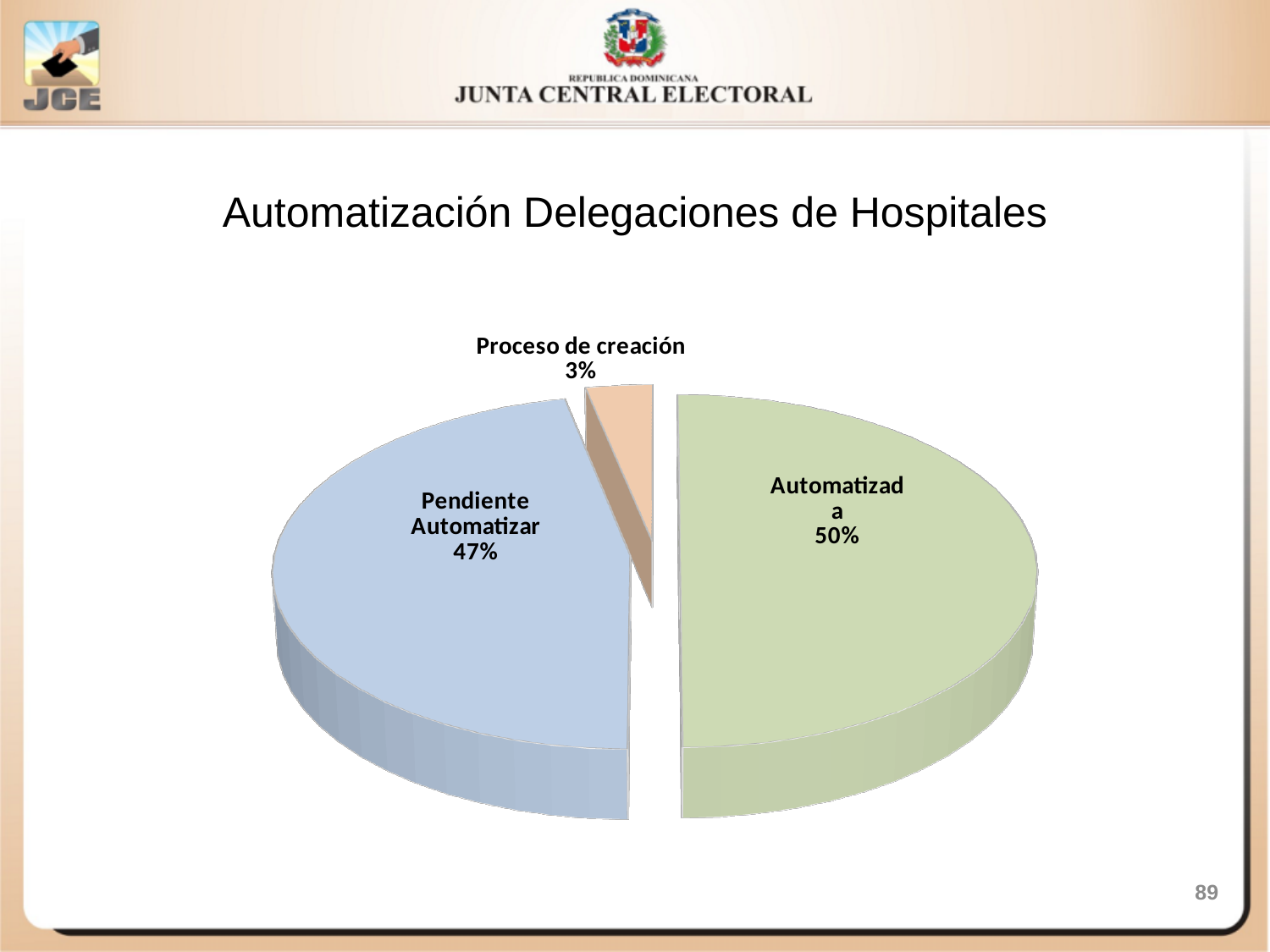
What is the title of the chart on the slide? Automatización Delegaciones de Hospitales What percentage of the pie is labelled "Automatizada"? 50% Which slice of the pie is the smallest? Proceso de creación What percentage of the pie is labelled "Pendiente Automatizar"? 47% What is the difference in percentage points between the "Automatizada" and "Pendiente Automatizar" slices? 3 Which is larger, the "Pendiente Automatizar" slice or the "Proceso de creación" slice? Pendiente Automatizar What percentage of the pie is labelled "Proceso de creación"? 3% What is the combined share of the "Pendiente Automatizar" and "Proceso de creación" slices? 50% What colour is the "Automatizada" slice of the pie? Green Which slice of the pie is the largest? Automatizada How many slices does the pie chart have? 3 What kind of chart is shown on the slide? Pie chart